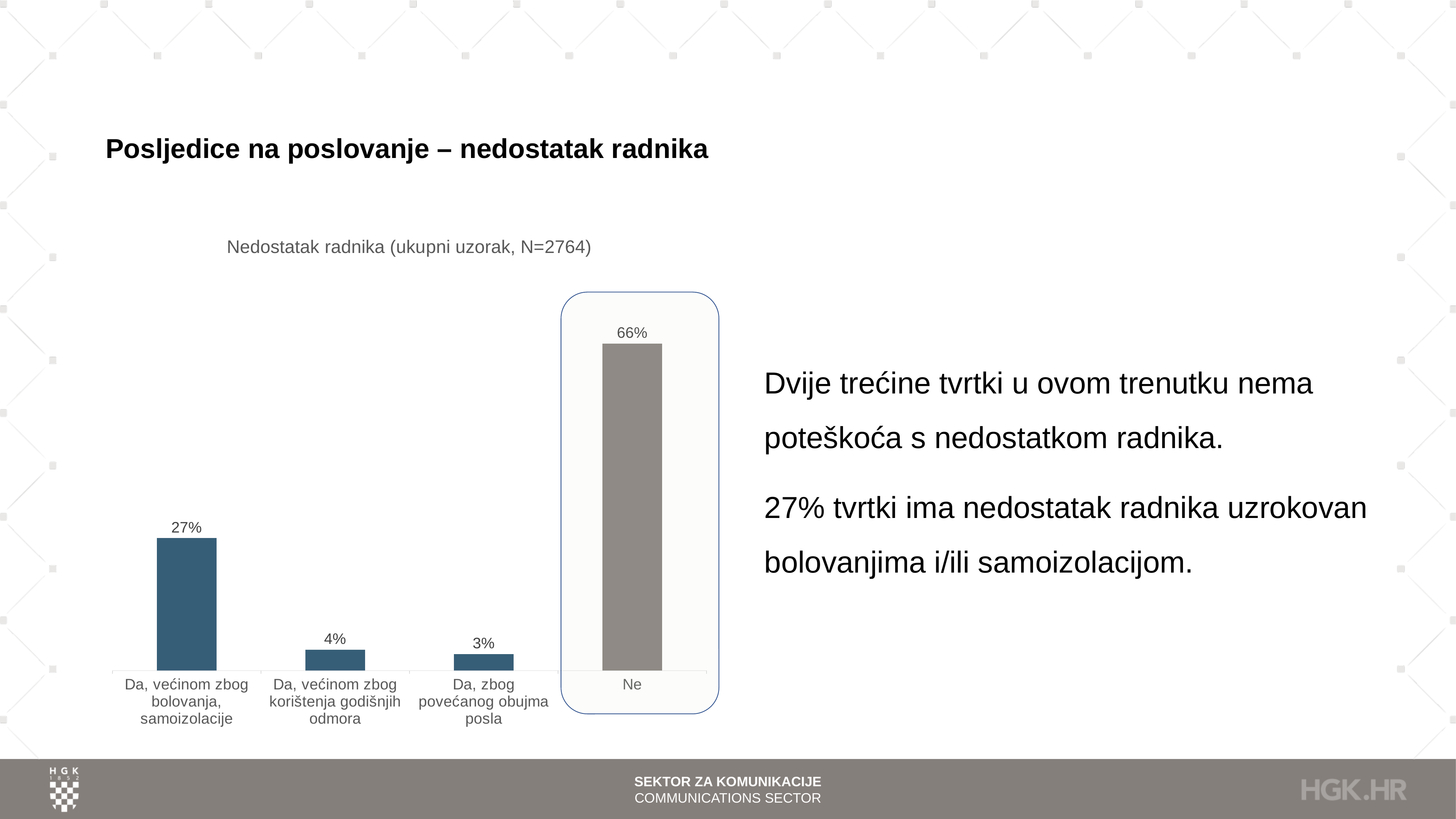
What is the value for "Da, većinom zbog korištenja godišnjih odmora"? 4% Which bar is shown in a different colour (grey) from the others? Ne Which is larger: the value for "Da, većinom zbog korištenja godišnjih odmora" or "Da, zbog povećanog obujma posla"? Da, većinom zbog korištenja godišnjih odmora What is the value for "Ne"? 66% What is the value for "Da, zbog povećanog obujma posla"? 3% What is the value for "Da, većinom zbog bolovanja, samoizolacije"? 27% How many categories are shown in the chart? 4 What is the difference between the values for "Ne" and "Da, većinom zbog bolovanja, samoizolacije"? 39% What kind of chart is shown on the slide? Bar chart What is the title of the chart? Nedostatak radnika (ukupni uzorak, N=2764) Which category has the highest value? Ne Which category has the lowest value? Da, zbog povećanog obujma posla